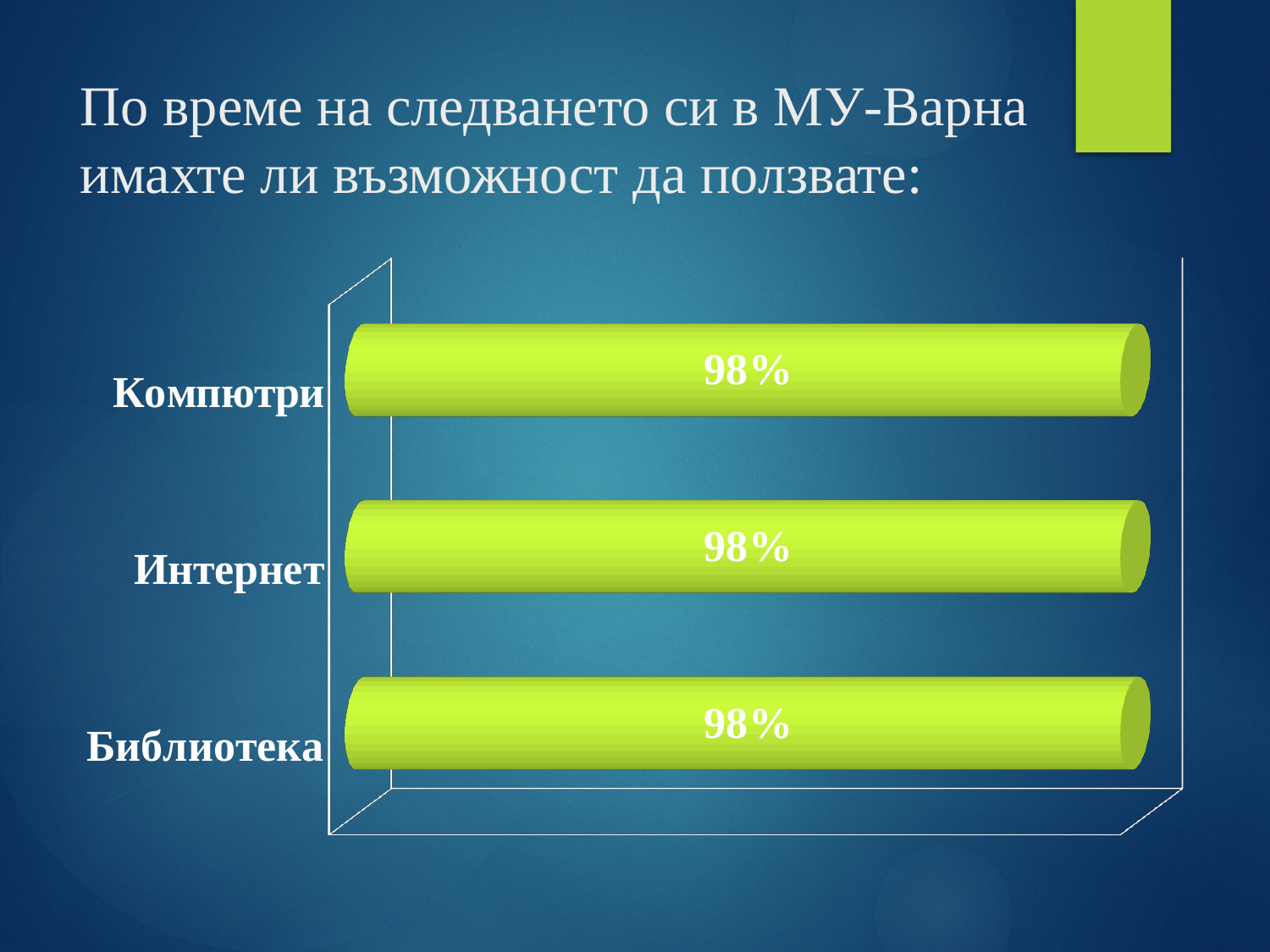
What is the value for Библиотека? 98% Which category is listed at the top of the chart? Компютри What kind of chart is shown on the slide? Bar chart What is the value for Интернет? 98% What colour are the bars in the chart? Green Is the value for Интернет greater or less than 50%? greater What is the difference between the values for Компютри and Библиотека? 0% What is the value for Компютри? 98% Do all three categories have the same value? Yes How many categories are shown in the chart? 3